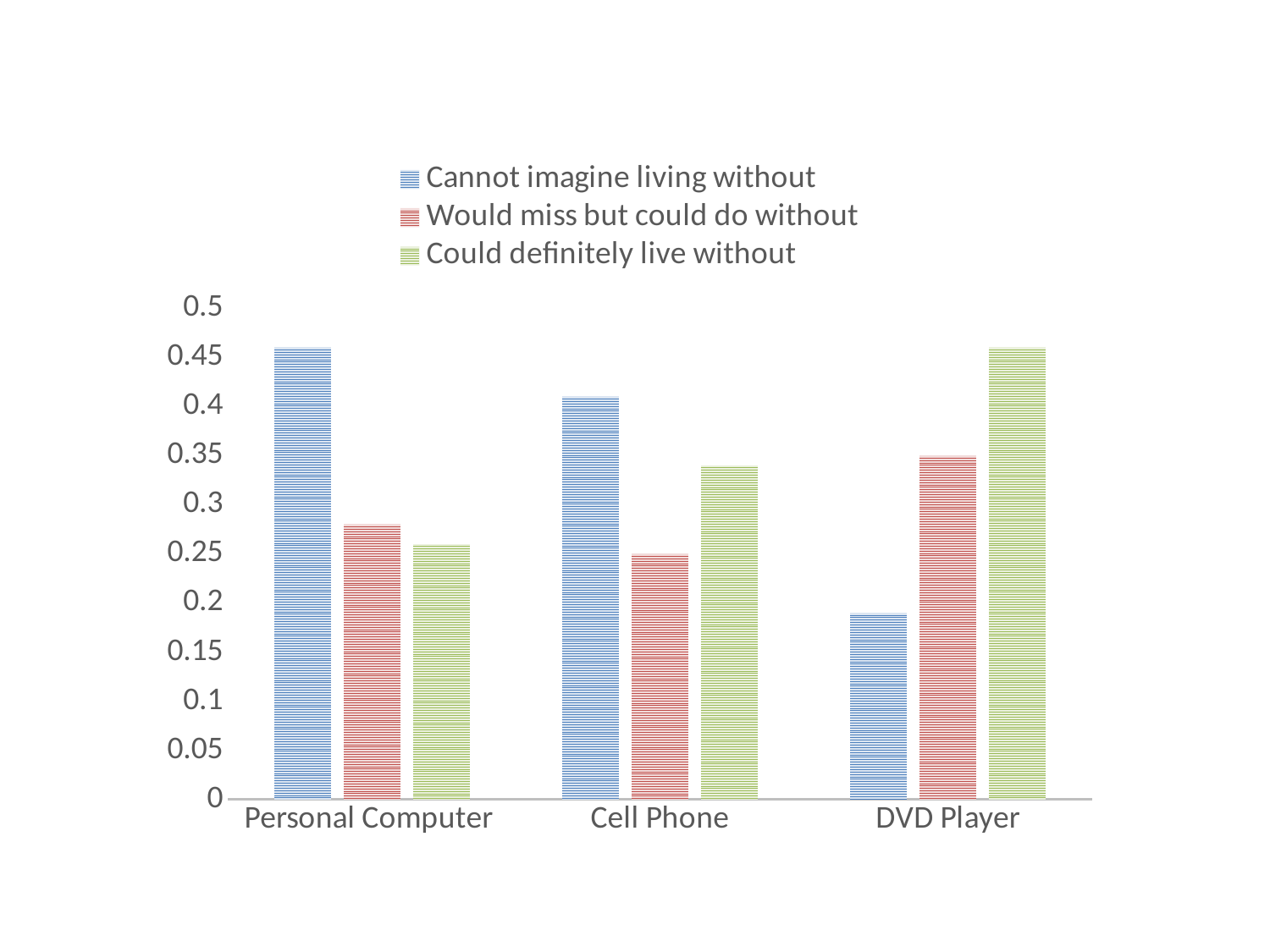
What kind of chart is shown on the slide? bar chart Which category has the lowest value for 'Cannot imagine living without'? DVD Player How many series does the legend list? 3 Is the 'Would miss but could do without' value for DVD Player greater or less than 0.3? greater Is the 'Cannot imagine living without' value for Personal Computer greater or less than 0.4? greater For Cell Phone, which is larger: 'Cannot imagine living without' or 'Could definitely live without'? Cannot imagine living without Which category has the highest value for 'Cannot imagine living without'? Personal Computer Which legend entry is shown in green? Could definitely live without Is the 'Would miss but could do without' value for Cell Phone greater or less than 0.3? less Which category has the highest value for 'Could definitely live without'? DVD Player How many categories are shown on the x axis? 3